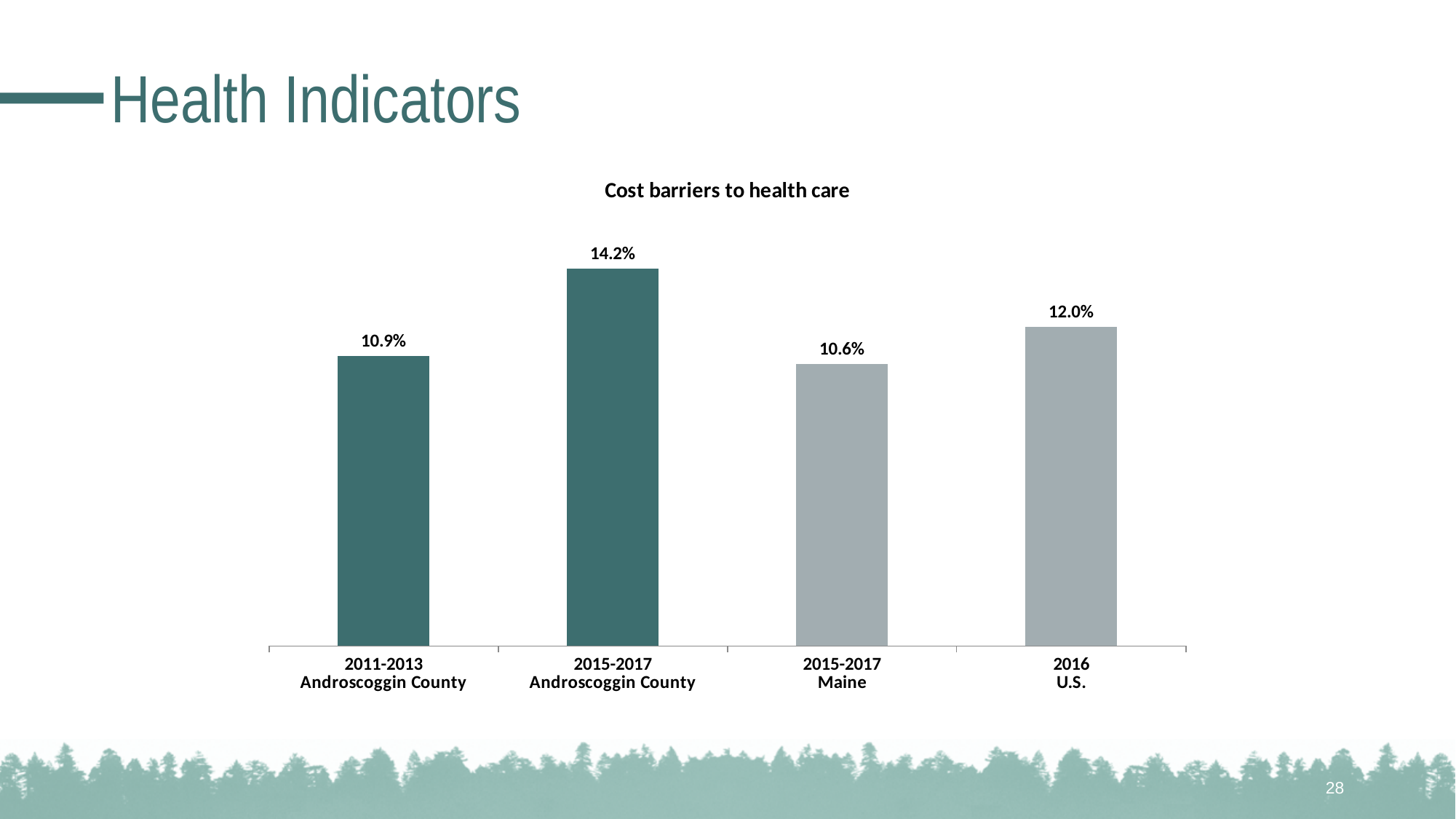
What is the value for 2016 U.S. in the Cost barriers to health care chart? 12.0% Which category has the lowest value in the Cost barriers to health care chart? 2015-2017 Maine What is the difference between the 2016 U.S. value and the 2015-2017 Maine value? 1.4% What is the title of the chart on the slide? Cost barriers to health care What is the difference between the 2015-2017 Androscoggin County value and the 2011-2013 Androscoggin County value? 3.3% Which category has the highest value in the Cost barriers to health care chart? 2015-2017 Androscoggin County What kind of chart is shown on the slide? Bar chart Which is larger: the value for 2015-2017 Androscoggin County or the value for 2016 U.S.? 2015-2017 Androscoggin County How many categories are shown in the Cost barriers to health care chart? 4 What is the value for 2011-2013 Androscoggin County in the Cost barriers to health care chart? 10.9% What is the value for 2015-2017 Androscoggin County in the Cost barriers to health care chart? 14.2% What is the value for 2015-2017 Maine in the Cost barriers to health care chart? 10.6%